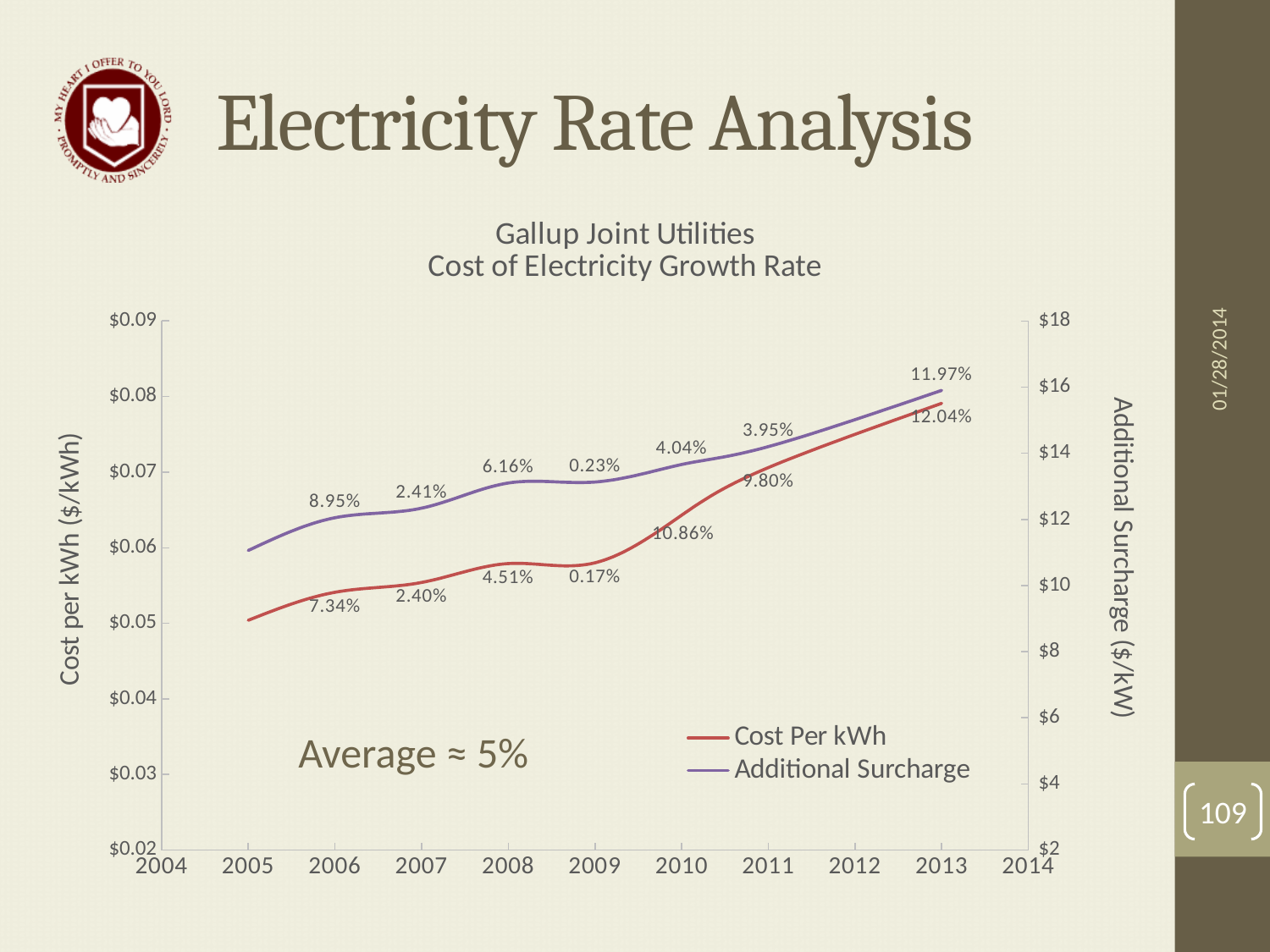
How many series does the chart legend list? 2 What growth-rate label is shown for Cost Per kWh in 2006? 7.34% Is the Cost Per kWh value in 2005 greater or less than $0.06? less What growth-rate label is shown for Cost Per kWh in 2010? 10.86% What is the highest growth-rate label shown for the Additional Surcharge series? 11.97% What growth-rate label is shown for Additional Surcharge in 2008? 6.16% What is the lowest growth-rate label shown for the Cost Per kWh series? 0.17% What average growth rate is annotated on the chart? Average ≈ 5% Does the Additional Surcharge line generally rise or fall from 2005 to 2013? rise What type of chart is shown on the slide? line chart Is the Cost Per kWh value in 2013 greater or less than $0.07? greater What is the title of the chart? Gallup Joint Utilities Cost of Electricity Growth Rate